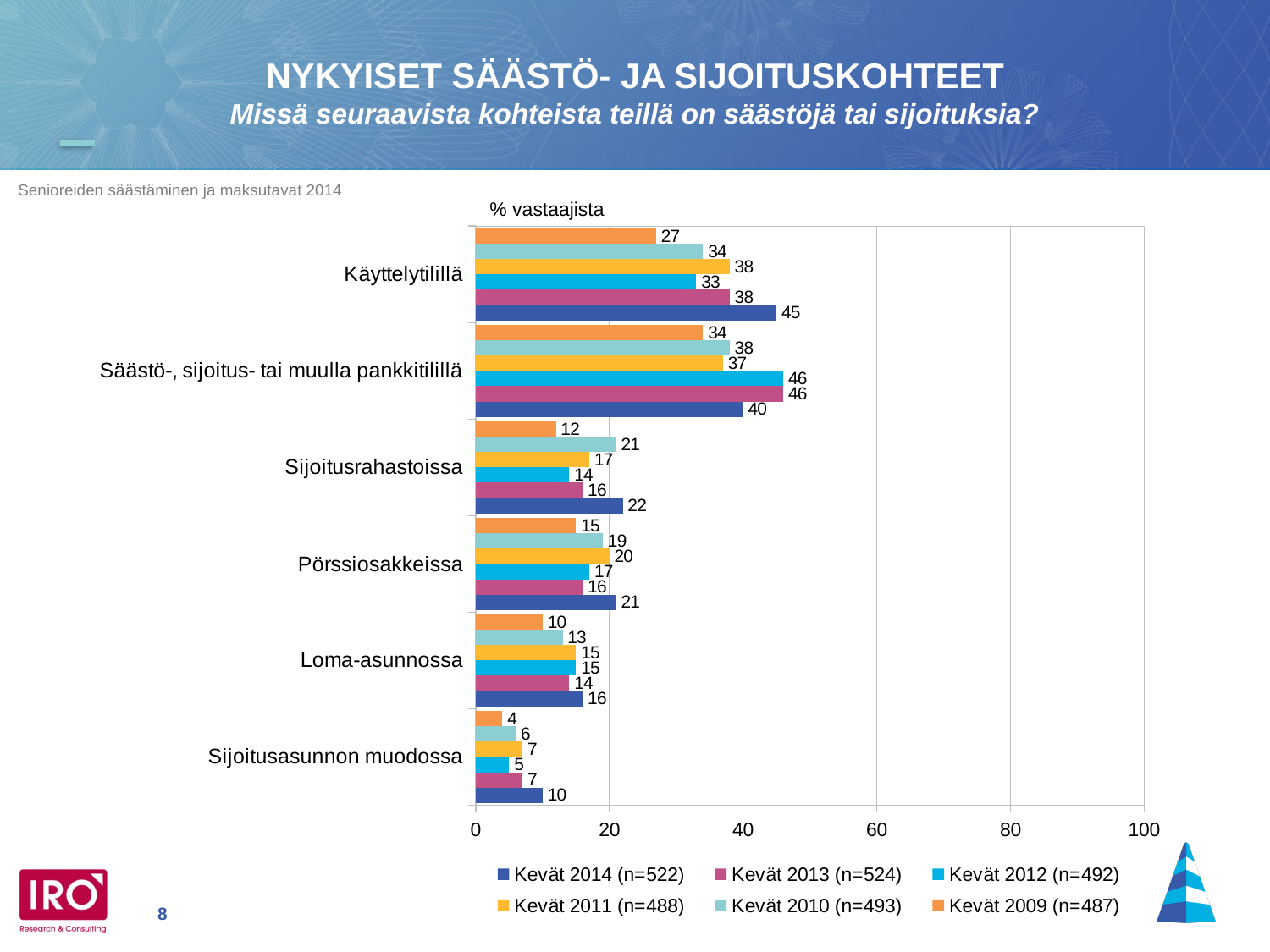
How many categories are shown on the chart? 6 Is the Kevät 2013 (n=524) value for Säästö-, sijoitus- tai muulla pankkitilillä greater or less than 40? greater Which category has the lowest value in the Kevät 2014 (n=522) series? Sijoitusasunnon muodossa Which category has the highest value in the Kevät 2012 (n=492) series? Säästö-, sijoitus- tai muulla pankkitilillä For Pörssiosakkeissa, which is larger: the Kevät 2011 (n=488) value or the Kevät 2013 (n=524) value? Kevät 2011 (n=488) How many series does the legend list? 6 What is the difference between the Kevät 2014 (n=522) and Kevät 2009 (n=487) values for Käyttelytilillä? 18 What is the value for Sijoitusrahastoissa in the Kevät 2010 (n=493) series? 21 What is the value for Sijoitusasunnon muodossa in the Kevät 2009 (n=487) series? 4 What is the value for Käyttelytilillä in the Kevät 2014 (n=522) series? 45 What is the label shown above the chart's plot area? % vastaajista What kind of chart is shown on the slide? Bar chart